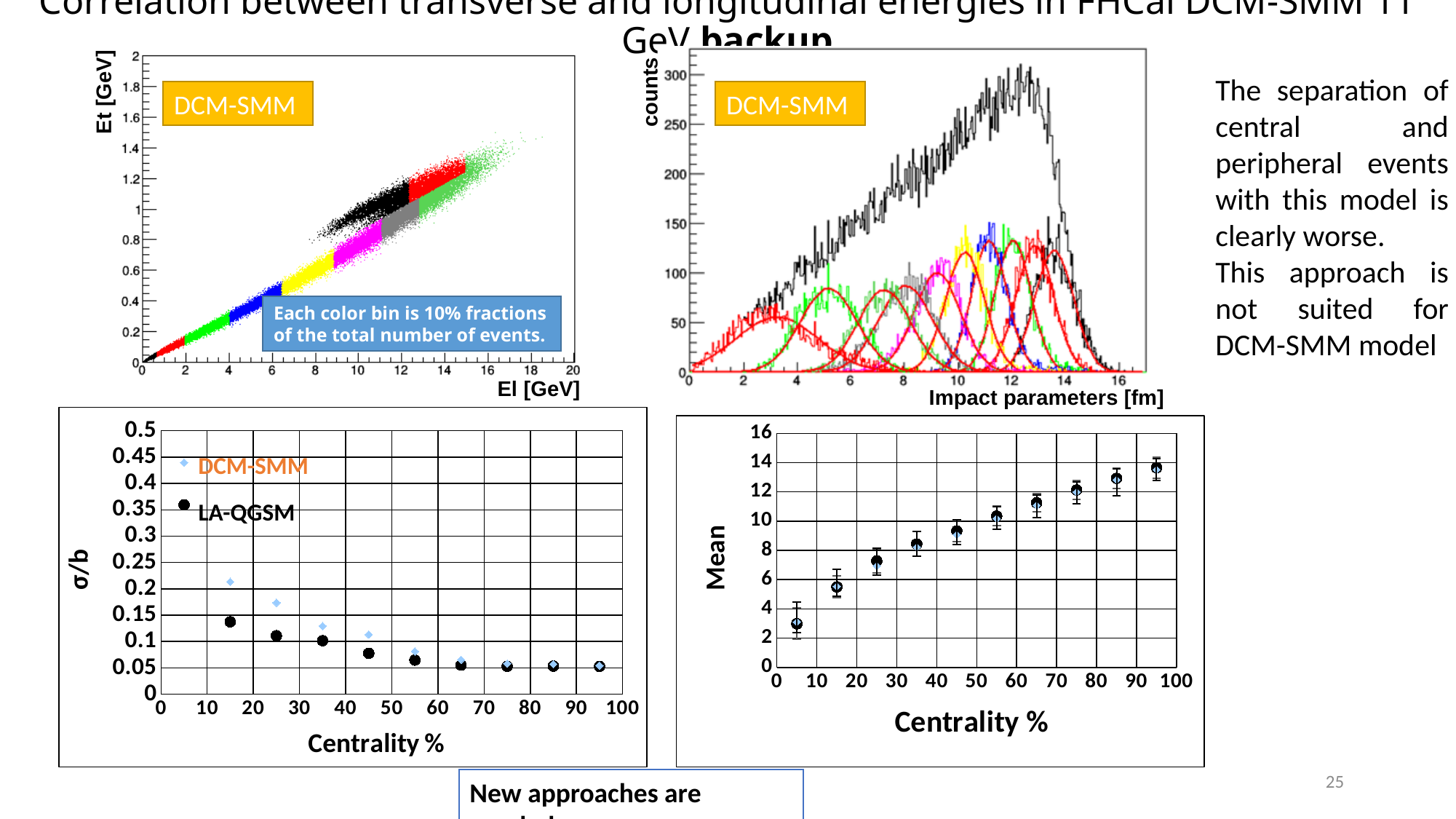
In the bottom-left chart (σ/b versus Centrality %), is the LA-QGSM value at 15% centrality greater or less than 0.15? less What kind of chart is the bottom-left chart of σ/b versus Centrality %? scatter chart In the bottom-right chart (Mean versus Centrality %), how many data points are plotted? 10 In the bottom-right chart (Mean versus Centrality %), is the Mean at 5% centrality greater or less than 4? less In the bottom-right chart (Mean versus Centrality %), at which centrality is the Mean highest? 95 In the bottom-left chart (σ/b versus Centrality %), how many series does the legend list? 2 In the bottom-left chart (σ/b versus Centrality %), do the σ/b values rise or fall as centrality increases? fall What is the x-axis label of the top-right histogram chart? Impact parameters [fm] In the bottom-right chart (Mean versus Centrality %), do the Mean values rise or fall as centrality increases? rise In the bottom-left chart (σ/b versus Centrality %), is the LA-QGSM value at 5% centrality greater or less than 0.3? greater In the bottom-left chart (σ/b versus Centrality %), what are the names of the two series in the legend? DCM-SMM and LA-QGSM In the bottom-left chart (σ/b versus Centrality %), at 25% centrality, which series has the larger σ/b value, DCM-SMM or LA-QGSM? DCM-SMM